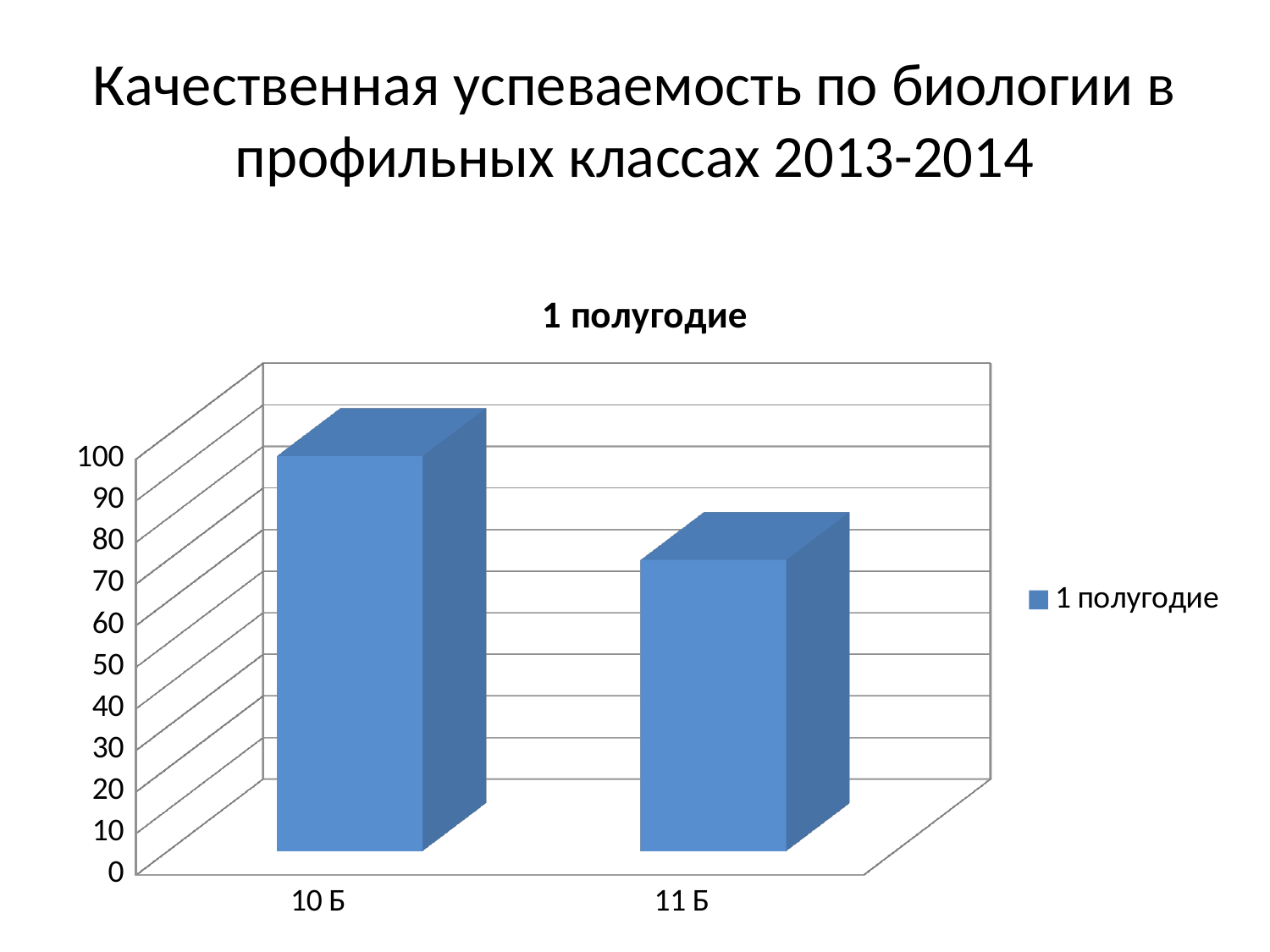
Which class has the highest value in the chart? 10 Б Which class has the lowest value in the chart? 11 Б How many series does the legend list? 1 What series name is shown in the chart legend? 1 полугодие Is the value for 10 Б greater or less than 80? greater How many categories are shown on the x axis of the chart? 2 Is the value for 11 Б greater or less than 90? less Which is larger, the value for 10 Б or the value for 11 Б? 10 Б What kind of chart is shown on the slide? bar chart Is the value for 11 Б greater or less than 50? greater What is the title of the chart? 1 полугодие